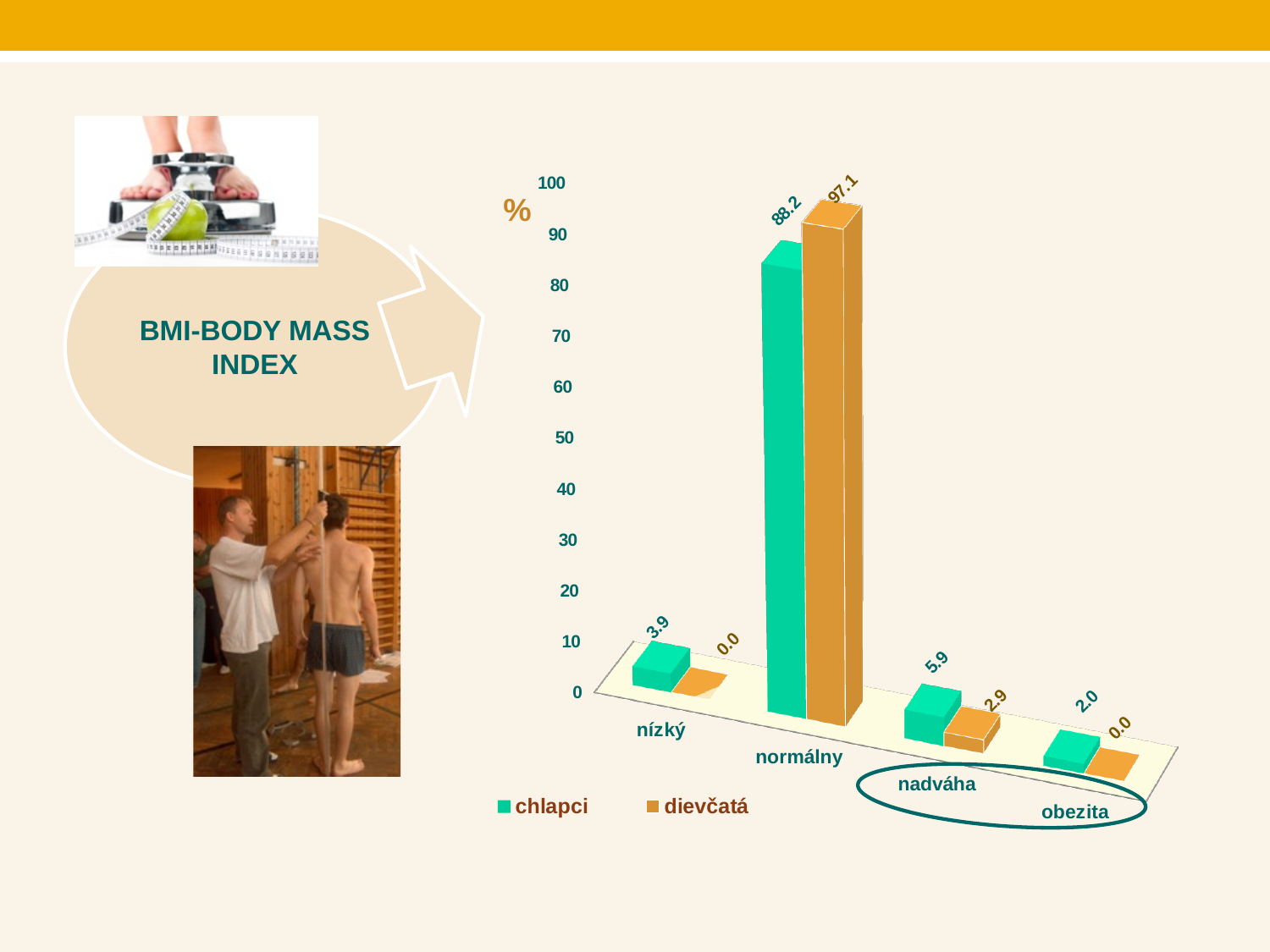
What kind of chart is shown on the slide? bar chart How many categories are shown on the x axis? 4 How many series does the legend list? 2 What is the value for dievčatá in the nízky category? 0.0 What is the value for chlapci in the obezita category? 2.0 Which category has the lowest value for chlapci? obezita What is the value for dievčatá in the normálny category? 97.1 What is the value for chlapci in the nadváha category? 5.9 Which category has the highest value for dievčatá? normálny What is the value for chlapci in the normálny category? 88.2 In the nadváha category, which series has the larger value, chlapci or dievčatá? chlapci What is the difference between the dievčatá and chlapci values in the normálny category? 8.9